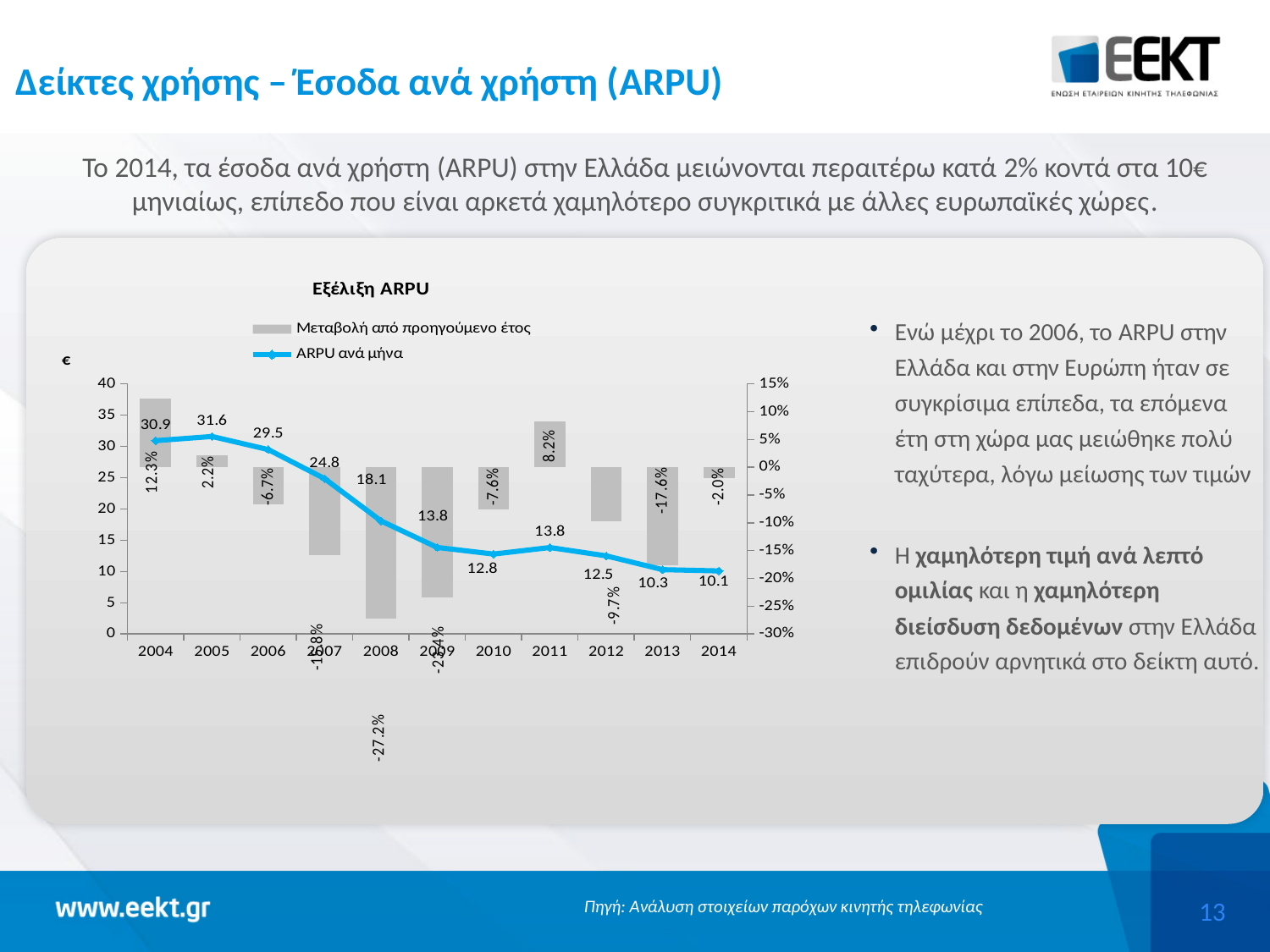
What is the title of the chart? Εξέλιξη ARPU What is the year-on-year change (Μεταβολή από προηγούμενο έτος) shown for 2008? -27.2% How many years are shown on the x axis of the chart? 11 What is the ARPU per month value for 2014? 10.1 What is the difference between the ARPU per month values for 2005 and 2014? 21.5 Which is larger, the ARPU per month value for 2010 or for 2011? 2011 What is the overall trend of the ARPU per month line from 2005 to 2014? Falling Which year has the lowest ARPU per month value? 2014 How many series does the chart legend list? 2 Which year has the highest ARPU per month value? 2005 What is the year-on-year change shown for 2011? 8.2% What is the ARPU per month value for 2004? 30.9